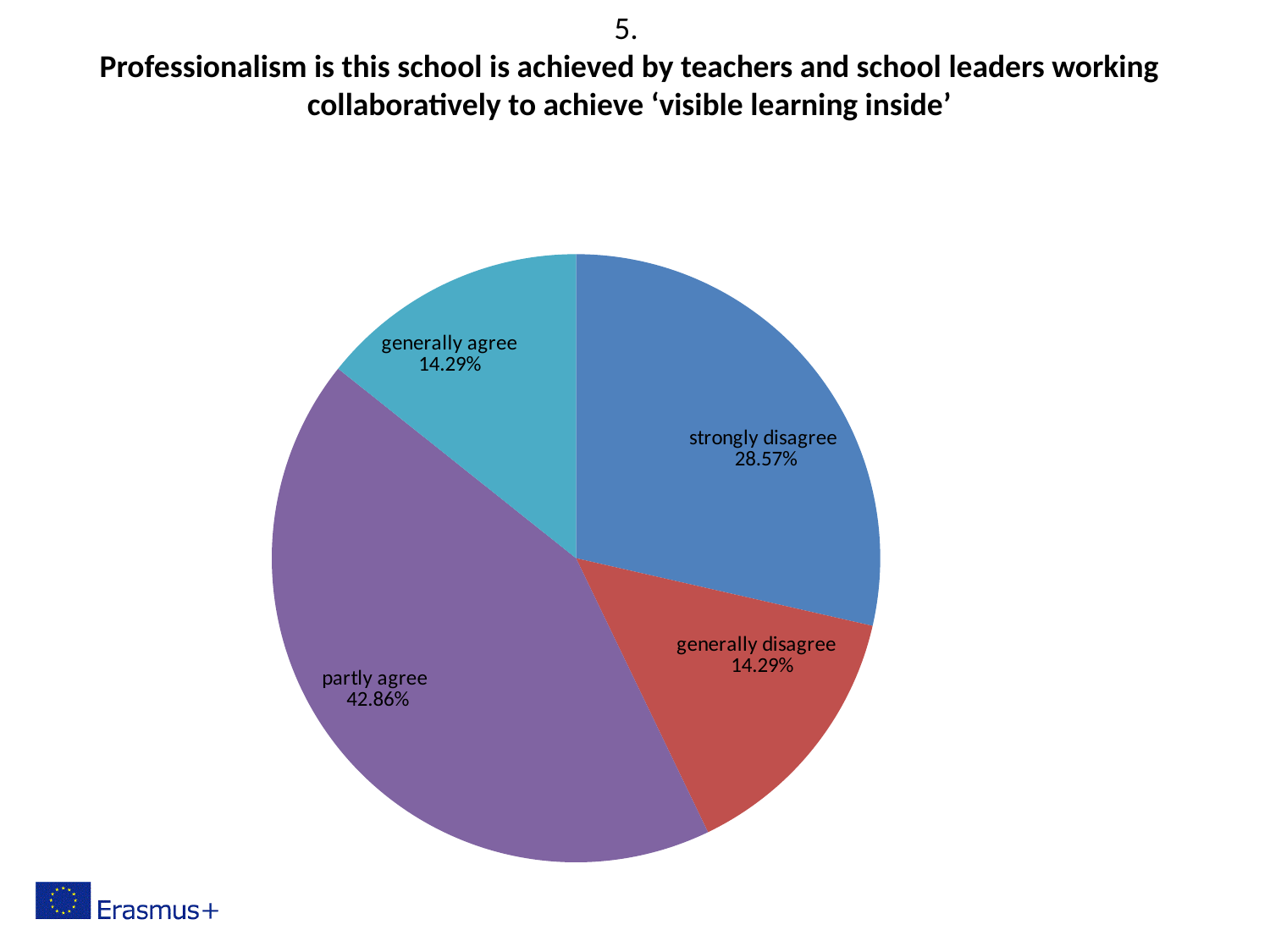
What is the difference in percentage points between 'strongly disagree' and 'generally disagree'? 14.28 What share of the pie is 'generally agree'? 14.29% How many slices does the pie chart have? 4 What share of the pie is 'strongly disagree'? 28.57% What is the combined share of 'strongly disagree' and 'generally disagree'? 42.86% What share of the pie is 'partly agree'? 42.86% Which category has the largest slice of the pie? partly agree What is the difference in percentage points between 'partly agree' and 'strongly disagree'? 14.29 Which is larger, the slice for 'strongly disagree' or the slice for 'generally agree'? strongly disagree What colour is the 'partly agree' slice? purple What kind of chart is shown on the slide? pie chart